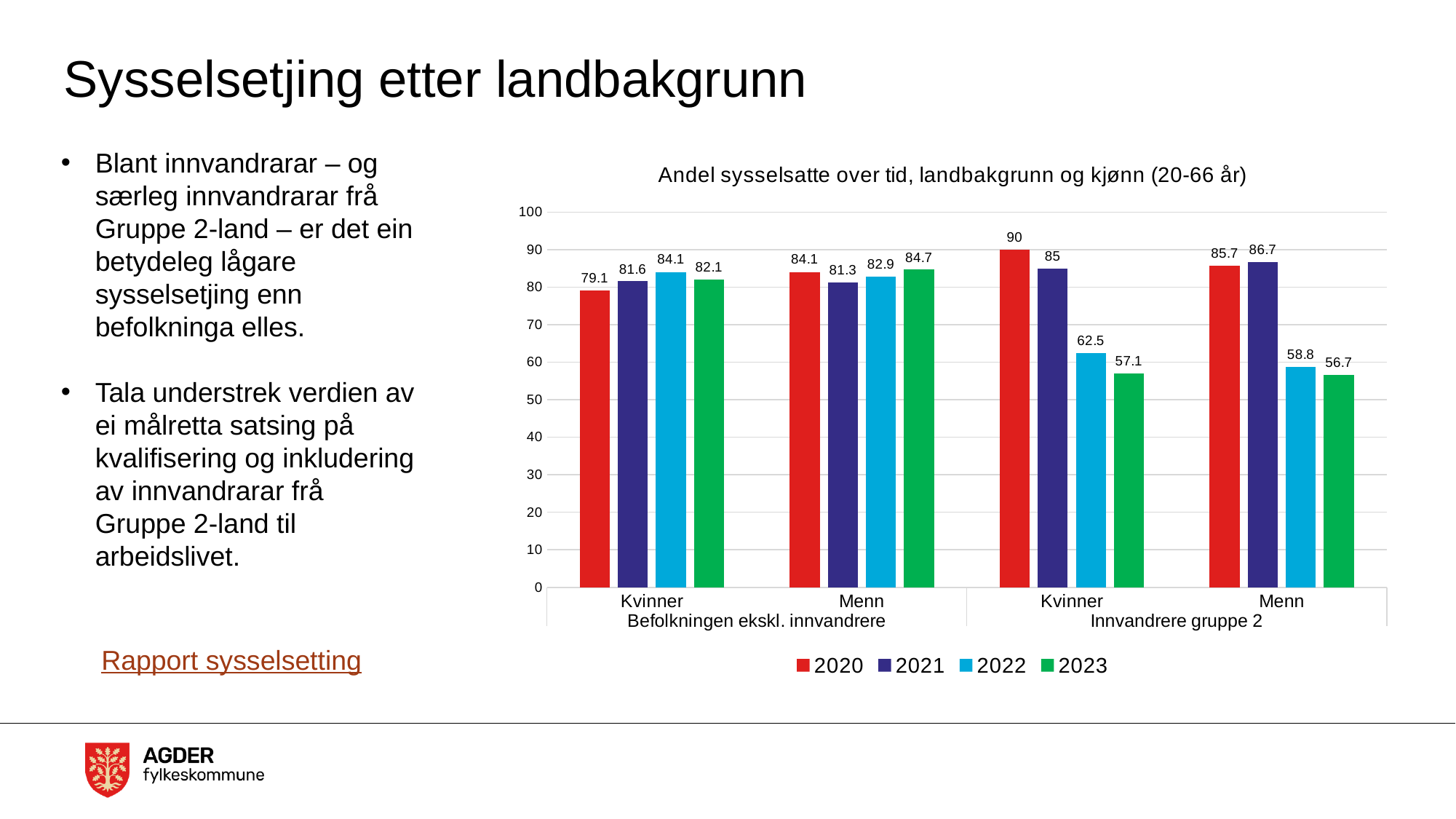
What is the difference between the 2020 and 2023 values for Kvinner in Innvandrere gruppe 2? 32.9 Which is larger: the 2023 value for Menn in Befolkningen ekskl. innvandrere or the 2023 value for Kvinner in Befolkningen ekskl. innvandrere? Menn in Befolkningen ekskl. innvandrere Which year has the highest value for Kvinner in Innvandrere gruppe 2? 2020 What is the title of the chart? Andel sysselsatte over tid, landbakgrunn og kjønn (20-66 år) What is the 2023 value for Menn in Innvandrere gruppe 2? 56.7 What is the 2022 value for Kvinner in Innvandrere gruppe 2? 62.5 What is the 2020 value for Kvinner in Befolkningen ekskl. innvandrere? 79.1 How many series does the legend list? 4 What type of chart is shown on the slide? Bar chart Do the values for Kvinner in Innvandrere gruppe 2 rise or fall from 2020 to 2023? Fall How many category groups are shown on the x axis? 4 Which year has the lowest value for Menn in Befolkningen ekskl. innvandrere? 2021